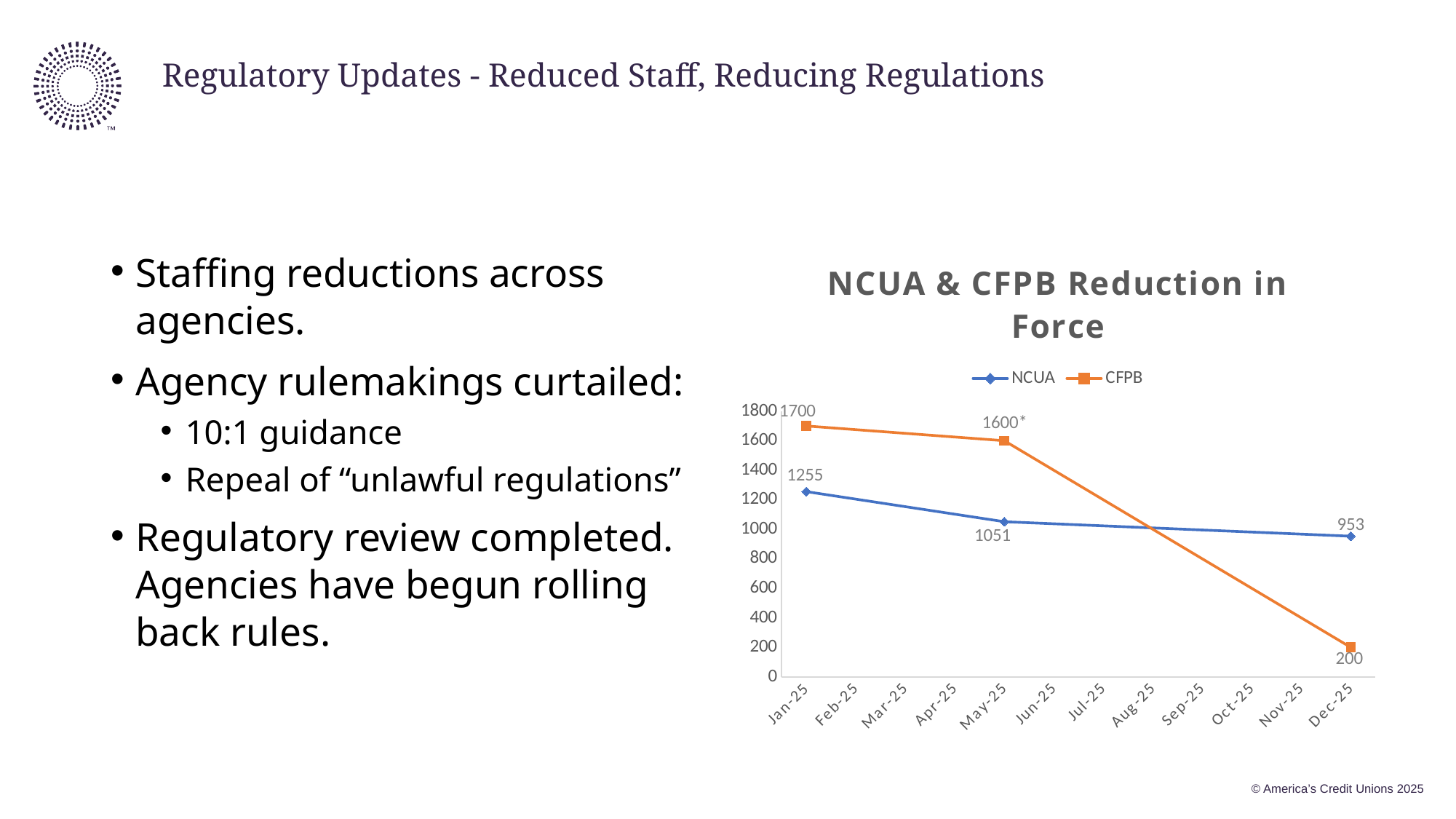
Does the CFPB line rise or fall from Jan-25 to Dec-25? fall How many month labels are shown on the x axis? 12 What is the NCUA value for Dec-25? 953 What is the NCUA value for Jan-25? 1255 What is the NCUA value for May-25? 1051 How many series does the chart legend list? 2 What is the title of the chart? NCUA & CFPB Reduction in Force What is the CFPB value for Jan-25? 1700 What is the difference between the NCUA values for Jan-25 and Dec-25? 302 What is the CFPB value for Dec-25? 200 Which series has the higher value in Dec-25, NCUA or CFPB? NCUA What type of chart is shown on the slide? line chart